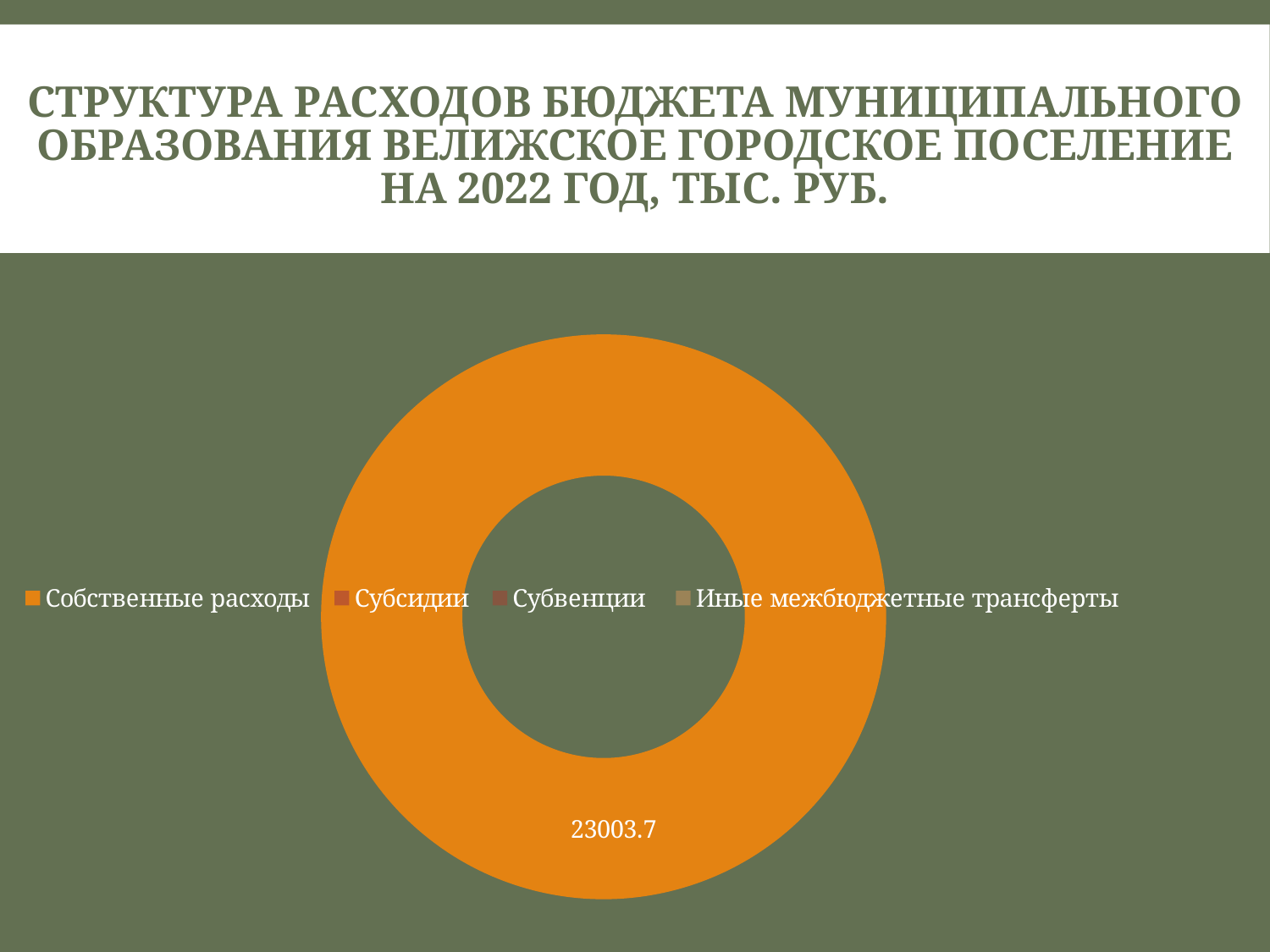
What value is shown on the chart for Собственные расходы? 23003.7 How many data labels are printed on the chart? 1 How many categories does the chart legend list? 4 Is the value for Собственные расходы greater or less than 20000? greater Which category accounts for the largest share of the chart? Собственные расходы What kind of chart is shown on the slide? Doughnut (pie) chart What is the last category listed in the chart legend? Иные межбюджетные трансферты What colour is used for Собственные расходы in the chart? Orange